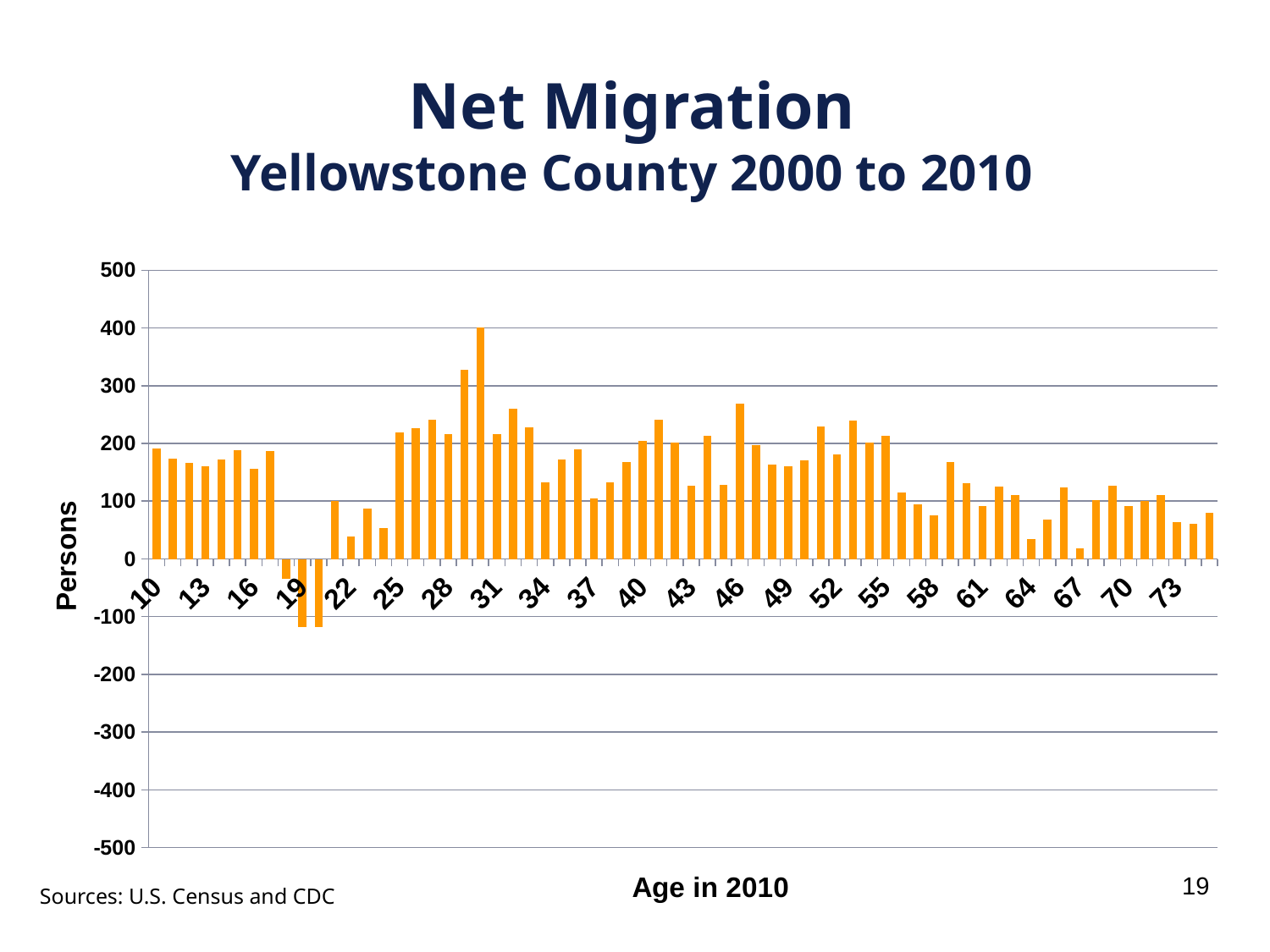
Is the value for age 67 greater or less than 100? less What is the title of the chart on the slide? Net Migration Yellowstone County 2000 to 2010 Is the highest bar on the chart greater or less than 300? greater Which is larger, the value for age 19 or the value for age 25? age 25 What is the label of the vertical axis? Persons Is the value for age 64 greater or less than 100? less What kind of chart is shown on the slide? bar chart What is the highest value shown on the vertical axis? 500 Which is larger, the value for age 10 or the value for age 64? age 10